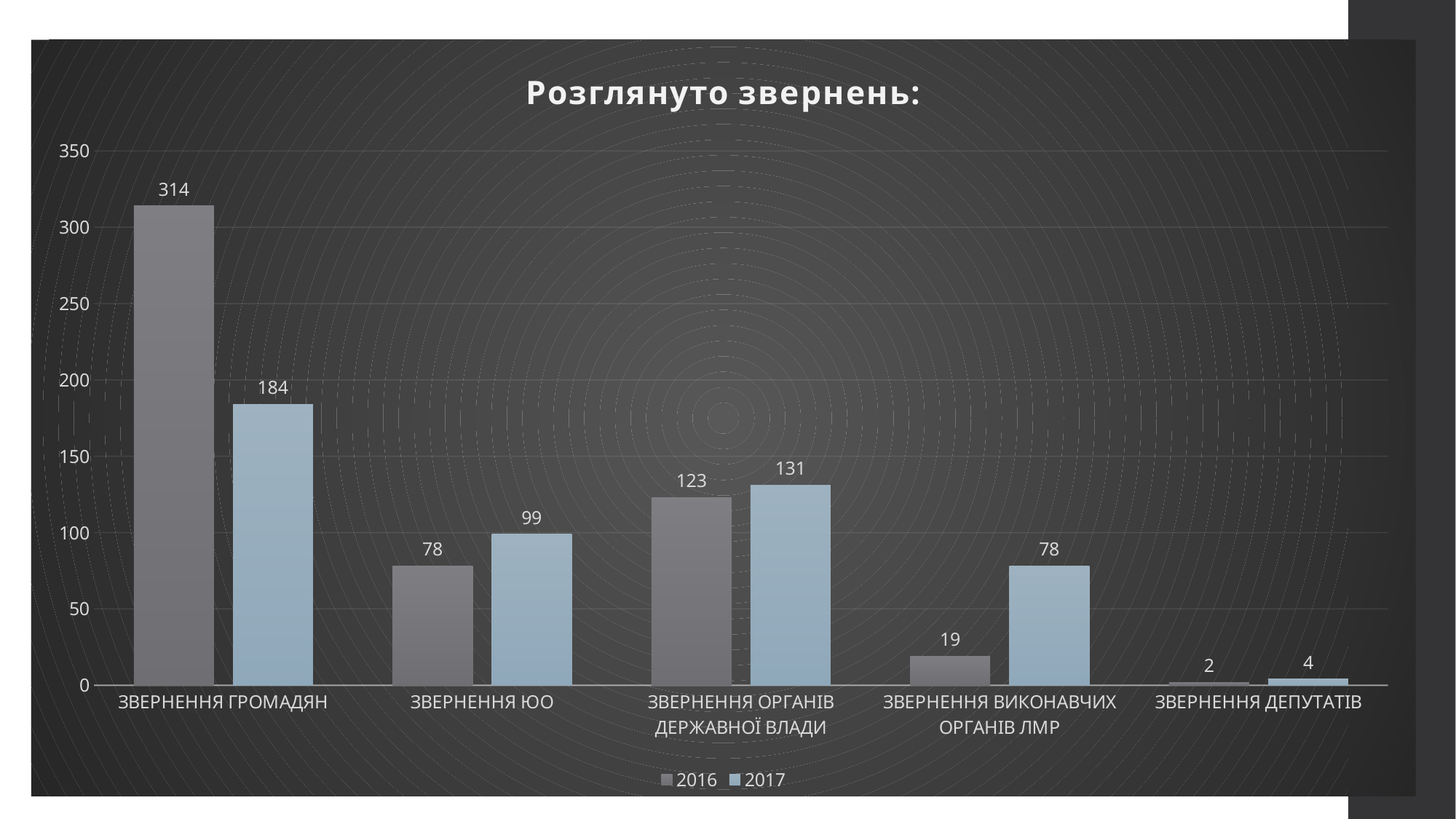
What is the value for ЗВЕРНЕННЯ ВИКОНАВЧИХ ОРГАНІВ ЛМР in the 2016 series? 19 Which category has the lowest value in the 2016 series? ЗВЕРНЕННЯ ДЕПУТАТІВ What is the value for ЗВЕРНЕННЯ ЮО in the 2017 series? 99 What is the difference between the 2016 and 2017 values for ЗВЕРНЕННЯ ГРОМАДЯН? 130 Which is larger for ЗВЕРНЕННЯ ОРГАНІВ ДЕРЖАВНОЇ ВЛАДИ: the 2016 value or the 2017 value? 2017 What is the value for ЗВЕРНЕННЯ ГРОМАДЯН in the 2016 series? 314 How many categories are shown on the x axis? 5 Is the 2017 value for ЗВЕРНЕННЯ ВИКОНАВЧИХ ОРГАНІВ ЛМР greater or less than 100? less Which category has the highest value in the 2017 series? ЗВЕРНЕННЯ ГРОМАДЯН How many series does the legend list? 2 What is the title of the chart? Розглянуто звернень: What kind of chart is shown on the slide? bar chart